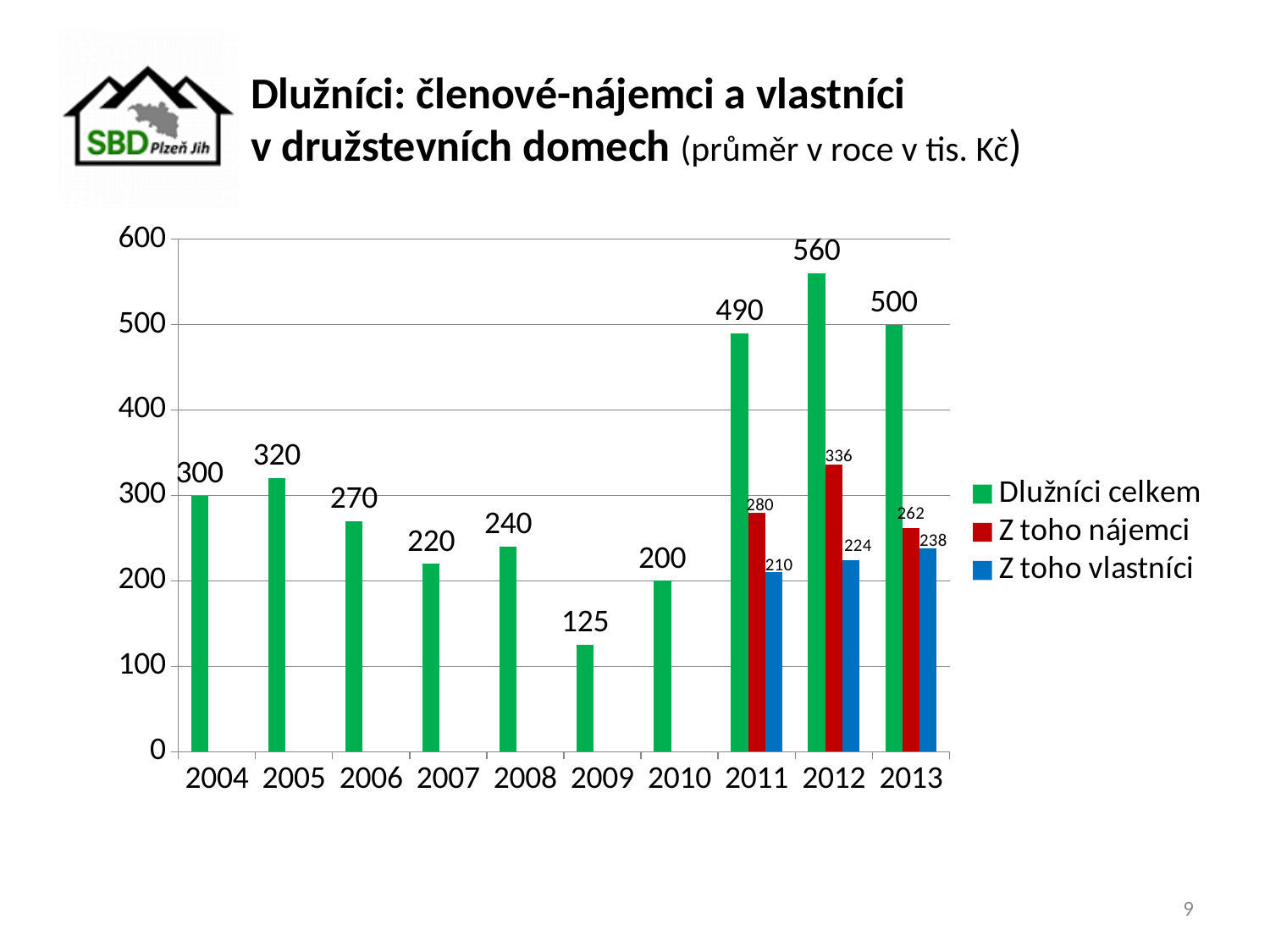
What kind of chart is shown on the slide? bar chart What is the value of Z toho vlastníci for 2013? 238 Which year has the lowest value for Dlužníci celkem? 2009 Which year has the highest value for Dlužníci celkem? 2012 Did Dlužníci celkem rise or fall from 2012 to 2013? fall What is the difference between Dlužníci celkem in 2012 and in 2013? 60 Which is larger in 2012: Z toho nájemci or Z toho vlastníci? Z toho nájemci What is the value of Z toho nájemci for 2011? 280 What is the value of Dlužníci celkem for 2012? 560 What colour are the bars for Z toho vlastníci? blue How many series does the legend list? 3 How many years are shown on the x axis? 10